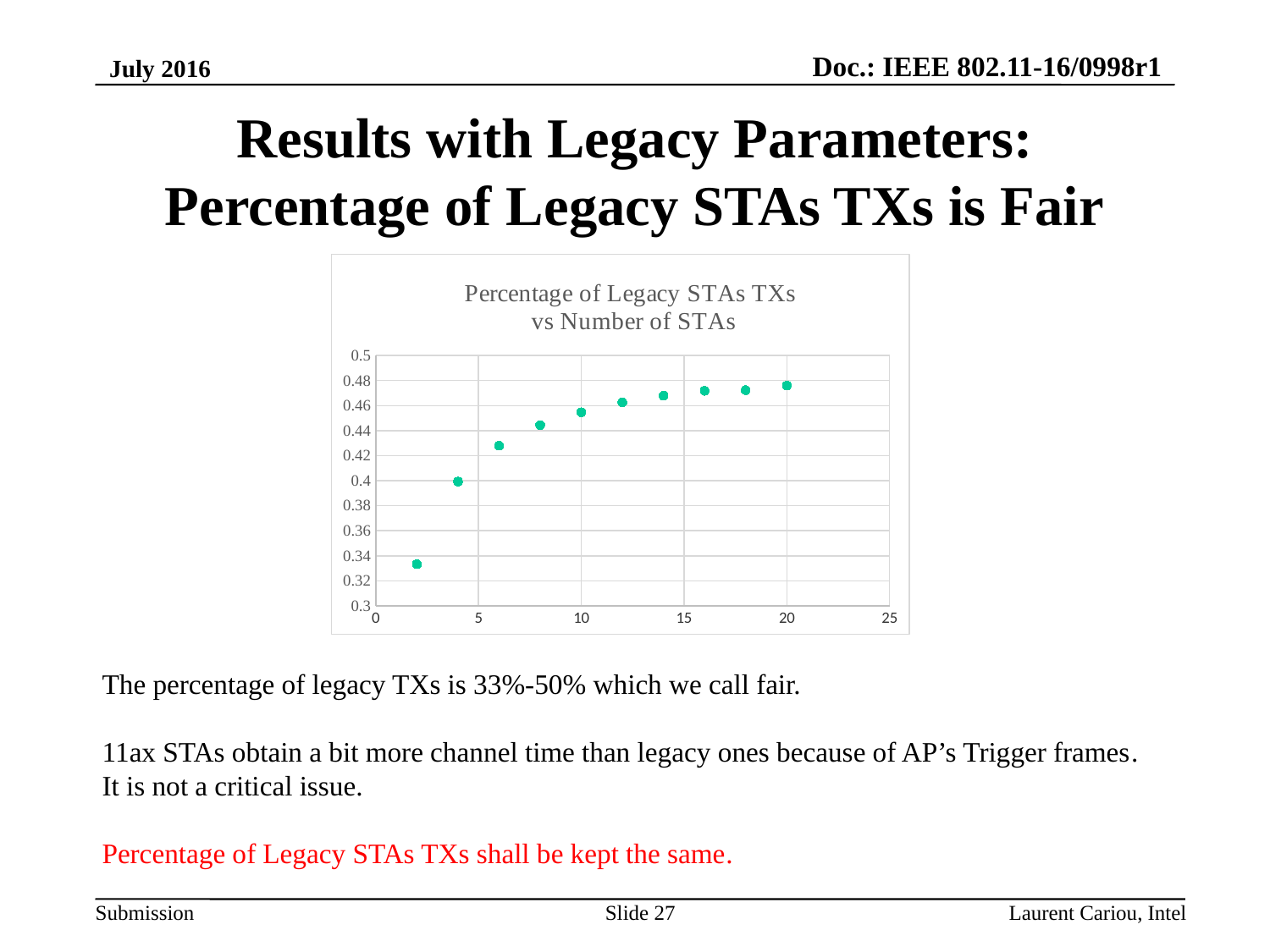
Is the value at 8 STAs greater or less than 0.42? greater Is the value at 20 STAs greater or less than 0.5? less Do the plotted values rise or fall as the number of STAs increases along the x axis? rise Is the value at 6 STAs greater or less than 0.42? greater What is the maximum value shown on the y axis of the chart? 0.5 Which is larger, the value at 4 STAs or the value at 12 STAs? 12 STAs At which number of STAs is the plotted value lowest? 2 What is the title of the chart? Percentage of Legacy STAs TXs vs Number of STAs How many data points are plotted in the chart? 10 What kind of chart is shown on the slide? scatter chart